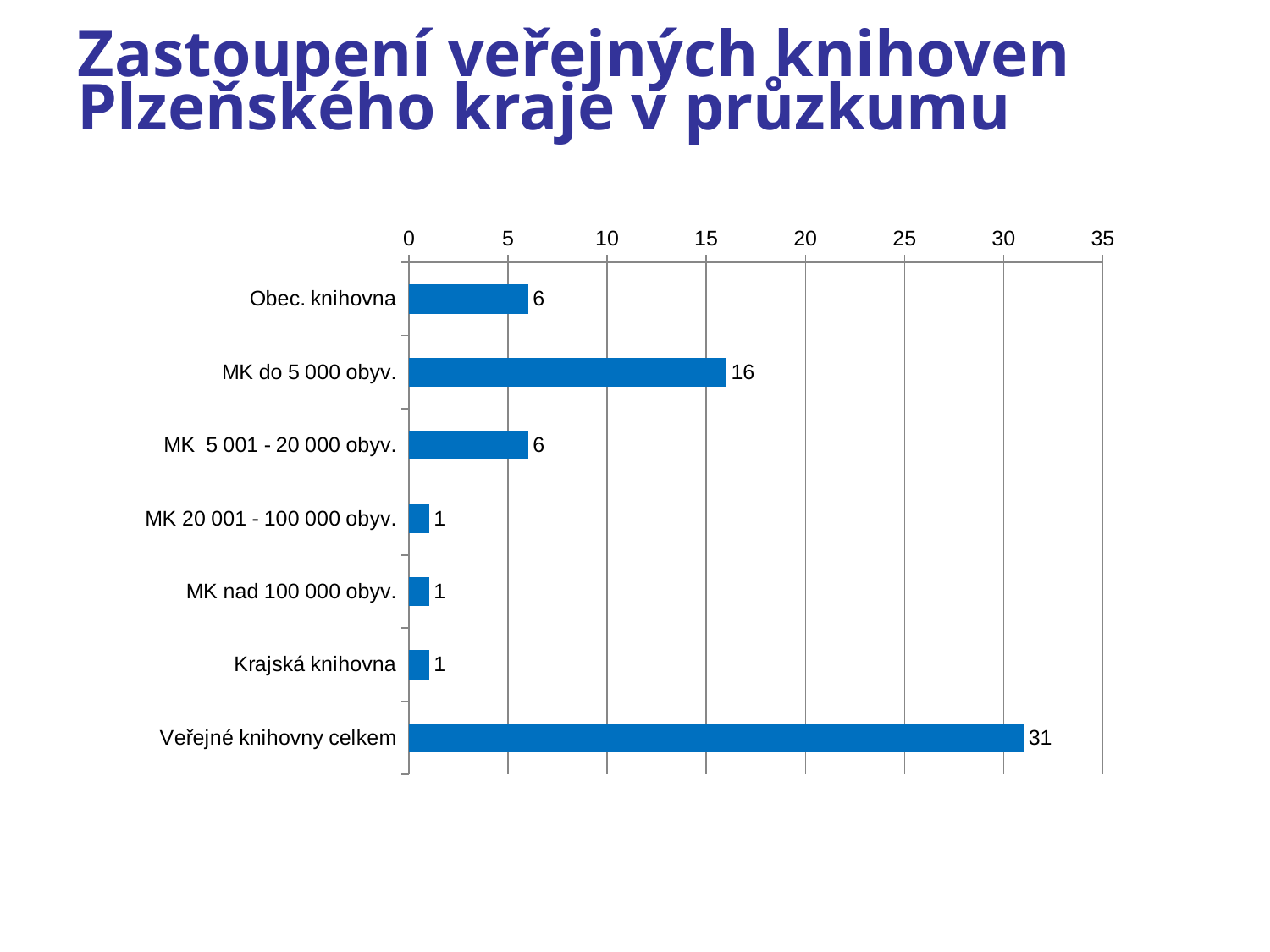
What is the value for Obec. knihovna? 6 Which is larger, the value for MK do 5 000 obyv. or the value for MK 5 001 - 20 000 obyv.? MK do 5 000 obyv. What is the value for MK do 5 000 obyv.? 16 What is the difference between the values for MK do 5 000 obyv. and Obec. knihovna? 10 What is the value for Krajská knihovna? 1 What is the title of the slide? Zastoupení veřejných knihoven Plzeňského kraje v průzkumu What is the difference between the values for Veřejné knihovny celkem and MK do 5 000 obyv.? 15 Is the value for Veřejné knihovny celkem greater or less than 30? greater What kind of chart is shown on the slide? bar chart Which category has the highest value? Veřejné knihovny celkem What is the value for Veřejné knihovny celkem? 31 How many categories are shown in the chart? 7